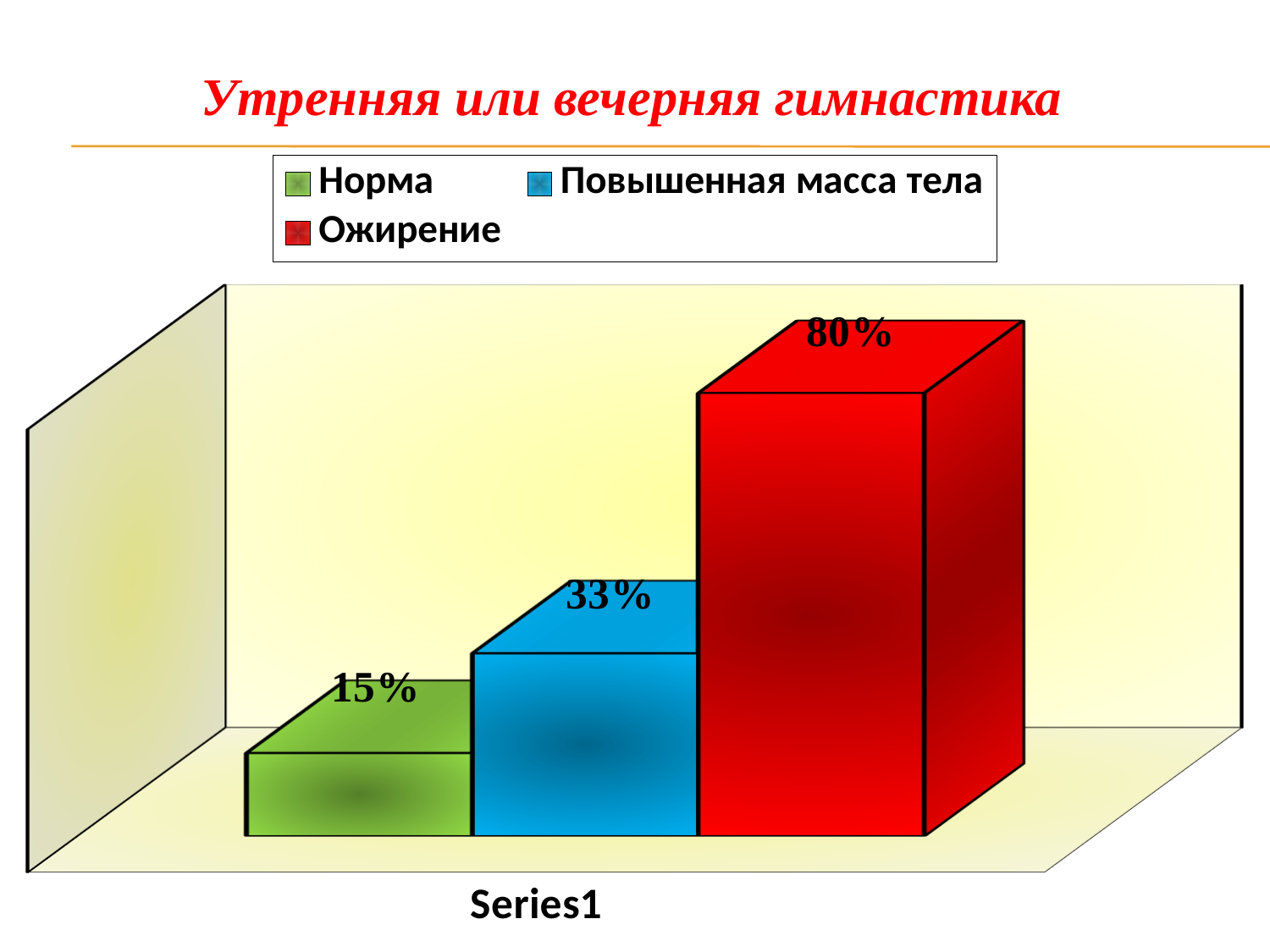
Which category has the lowest value? Норма How many bars are plotted on the chart? 3 What kind of chart is shown on the slide? bar chart What is the difference between the values for Повышенная масса тела and Норма? 18% What is the difference between the values for Ожирение and Норма? 65% Which category has the highest value? Ожирение What is the value for Ожирение? 80% How many entries does the legend list? 3 What colour is the bar for Ожирение? red What is the value for Норма? 15% What is the value for Повышенная масса тела? 33% Which is larger, the value for Повышенная масса тела or the value for Норма? Повышенная масса тела